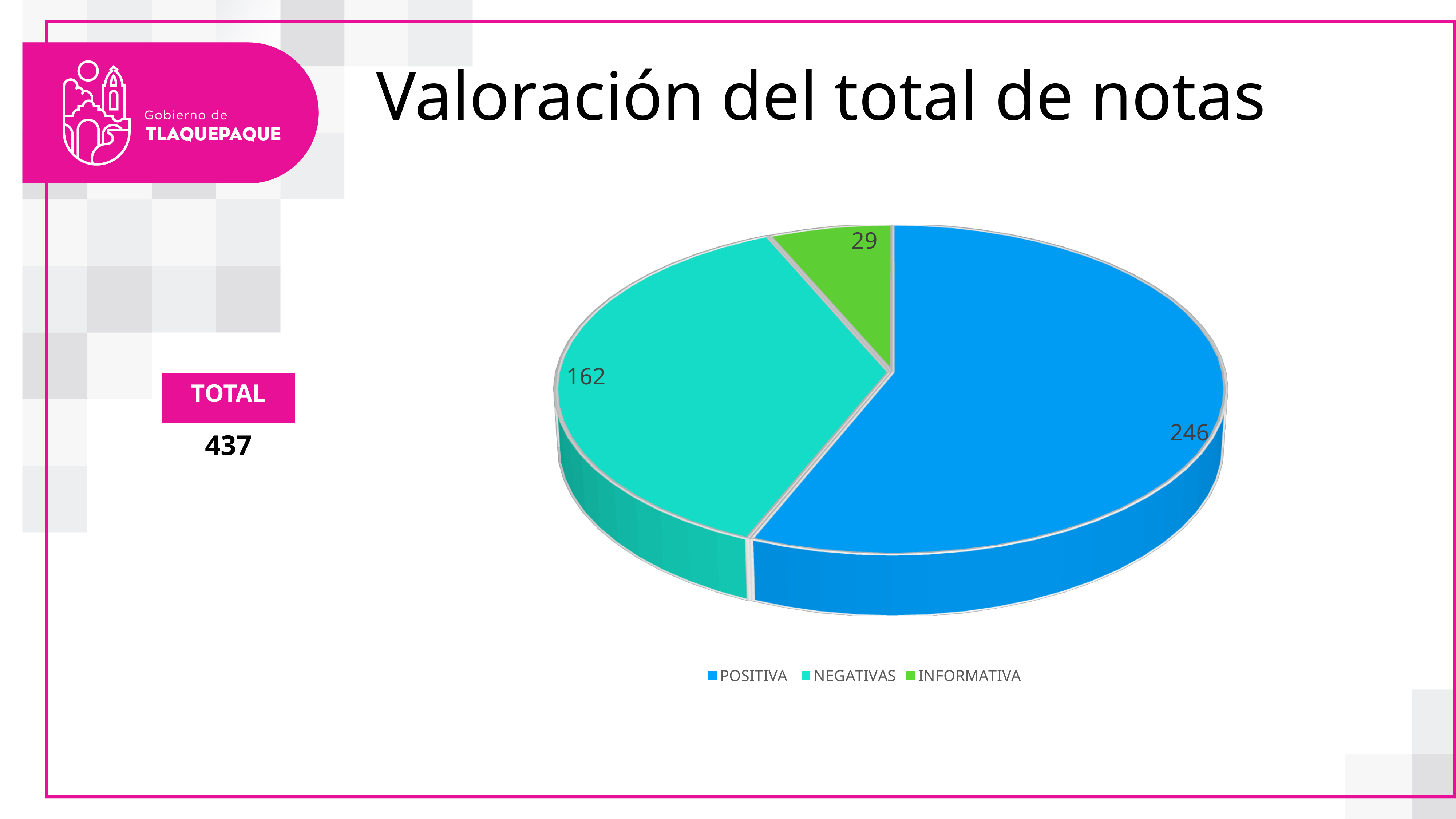
What is the title of the chart? Valoración del total de notas What is the value for INFORMATIVA? 29 What type of chart is shown on the slide? pie chart Which is larger, NEGATIVAS or INFORMATIVA? NEGATIVAS What is the difference between the POSITIVA and NEGATIVAS values? 84 How many slices does the pie chart have? 3 What is the value for NEGATIVAS? 162 Which category has the smallest slice? INFORMATIVA What is the value for POSITIVA? 246 Which category has the largest slice? POSITIVA What is the total of all slices in the pie chart? 437 What is the difference between the NEGATIVAS and INFORMATIVA values? 133